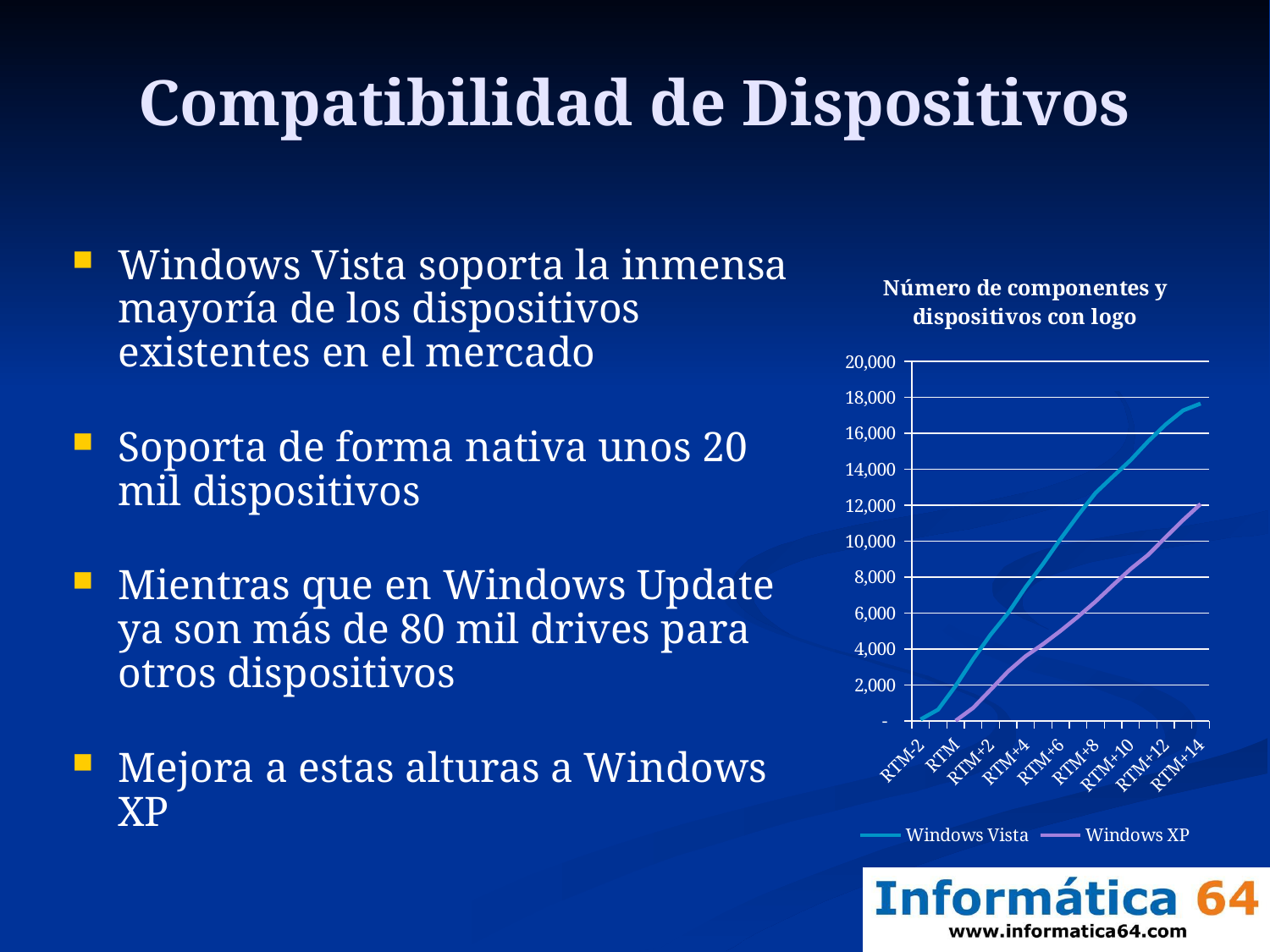
Which series reaches the highest value on the chart? Windows Vista Which series has the higher value at RTM+10, Windows Vista or Windows XP? Windows Vista Do the values for Windows Vista rise or fall from RTM-2 to RTM+14? rise What is the title of the chart? Número de componentes y dispositivos con logo Is the value for Windows XP at RTM+4 greater or less than 6,000? less How many series does the chart legend list? 2 Is the value for Windows XP at RTM+14 greater or less than 14,000? less Is the value for Windows Vista at RTM+14 greater or less than 16,000? greater Which two series are listed in the chart legend? Windows Vista and Windows XP How many category labels are shown along the x axis of the chart? 9 Do the values for Windows XP rise or fall along the x axis? rise What kind of chart is shown on the slide? line chart